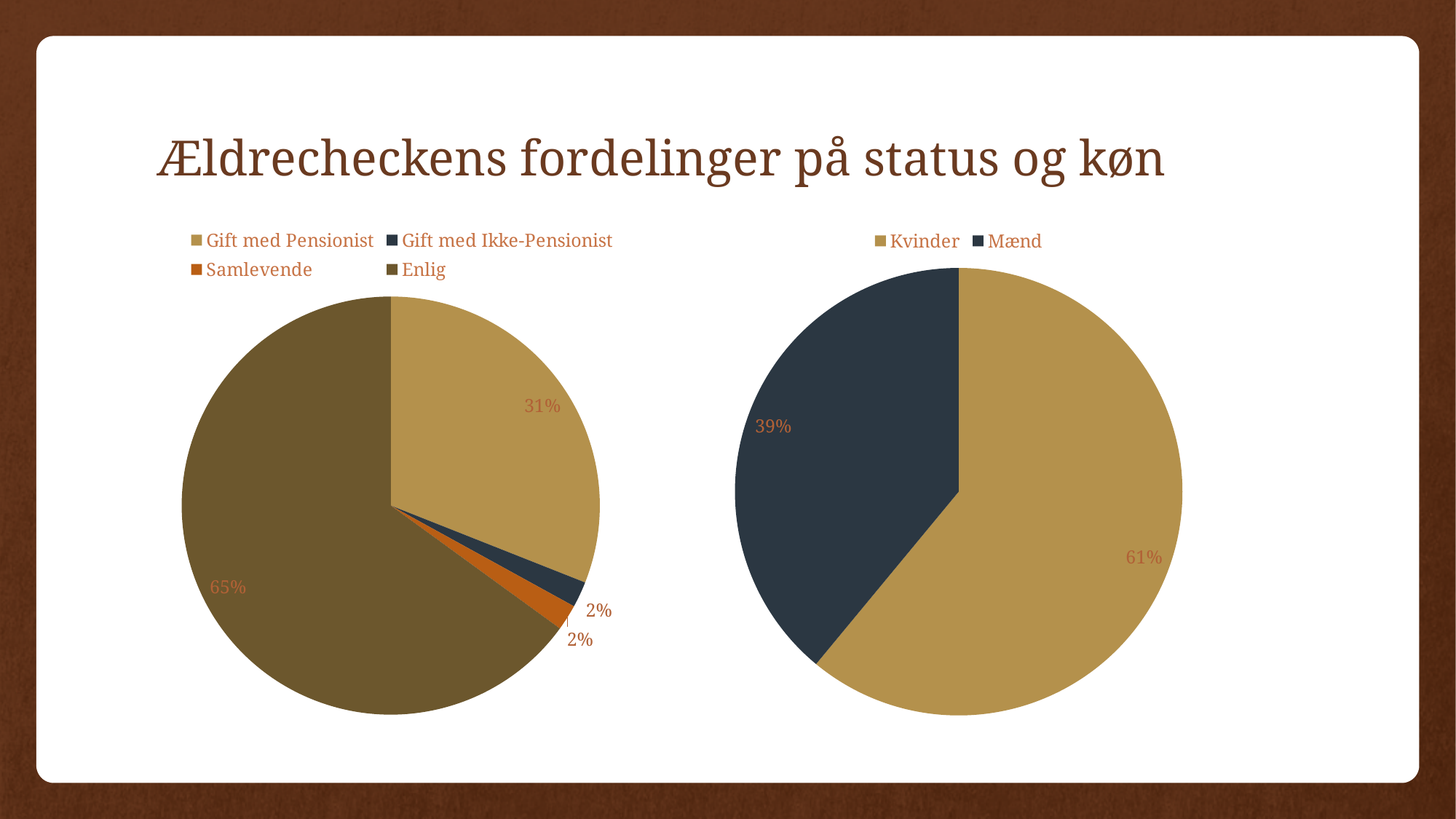
In the left pie chart, what share does Enlig have? 65% In the left pie chart, what share does Gift med Pensionist have? 31% In the left pie chart, which category has the largest slice? Enlig In the right pie chart, what share does Mænd have? 39% In the left pie chart, what is the difference between the shares of Enlig and Gift med Pensionist? 34 percentage points In the right pie chart, which category has the smaller slice? Mænd What kind of chart is the right chart on the slide? Pie chart In the left pie chart, which is larger, Gift med Pensionist or Enlig? Enlig In the left pie chart, how many categories does the legend list? 4 In the right pie chart, what is the difference between the shares of Kvinder and Mænd? 22 percentage points